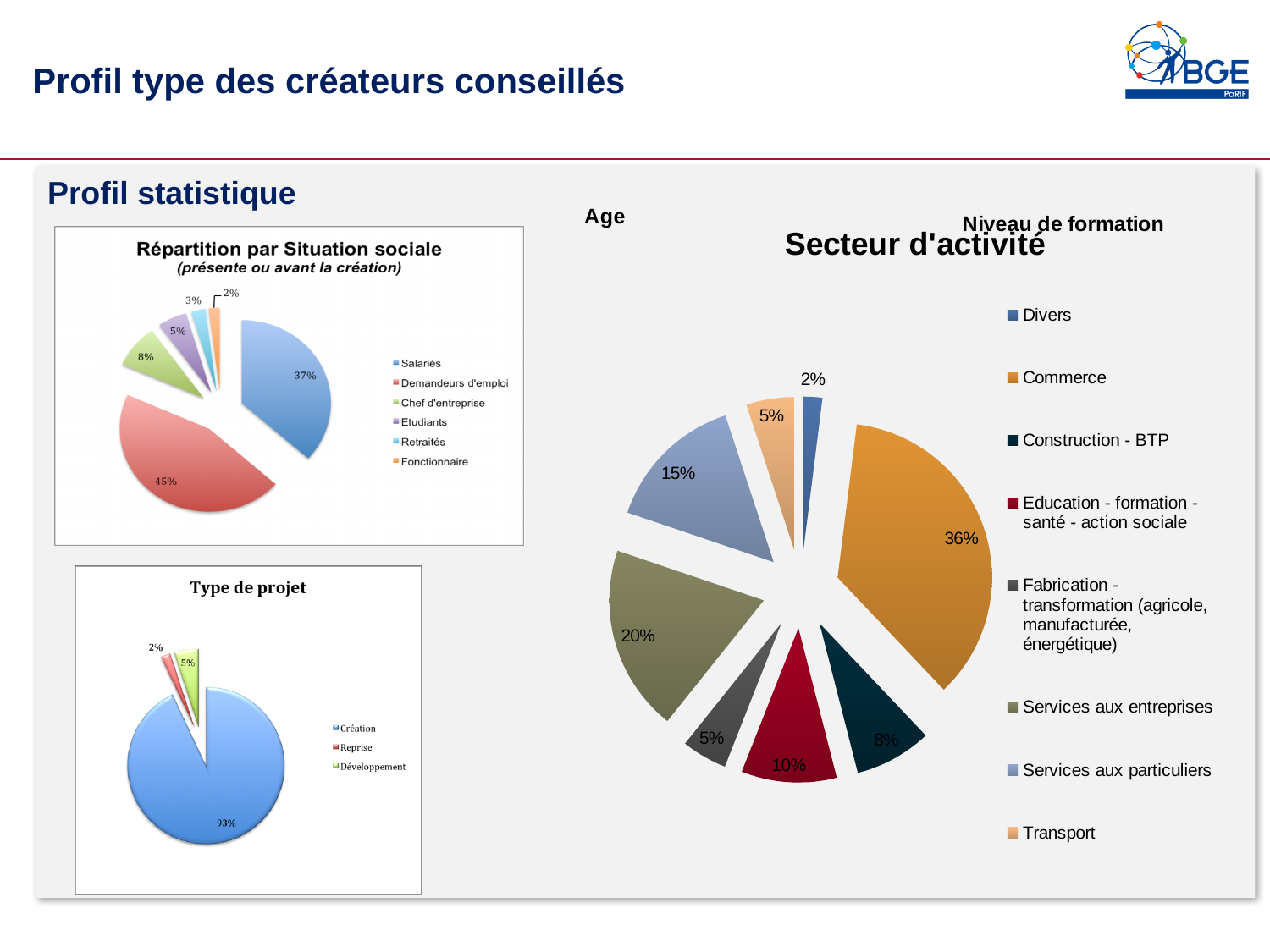
In the 'Type de projet' chart, which category has the smallest share? Reprise In the 'Type de projet' chart, what share does Création have? 93% In the 'Secteur d'activité' chart, what is the difference between the shares of Services aux entreprises and Services aux particuliers? 5% In the 'Répartition par Situation sociale' chart, which category has the largest share? Demandeurs d'emploi What kind of chart is 'Répartition par Situation sociale'? Pie chart In the 'Secteur d'activité' chart, what share does Commerce have? 36% In the 'Répartition par Situation sociale' chart, what share do Demandeurs d'emploi have? 45% In the 'Répartition par Situation sociale' chart, what is the difference between Salariés and Chef d'entreprise? 29% In the 'Secteur d'activité' chart, which sector has the smallest share? Divers In the 'Secteur d'activité' chart, which is larger: Construction - BTP or Education - formation - santé - action sociale? Education - formation - santé - action sociale In the 'Secteur d'activité' chart, how many sectors does the legend list? 8 In the 'Secteur d'activité' chart, which sector has the largest share? Commerce